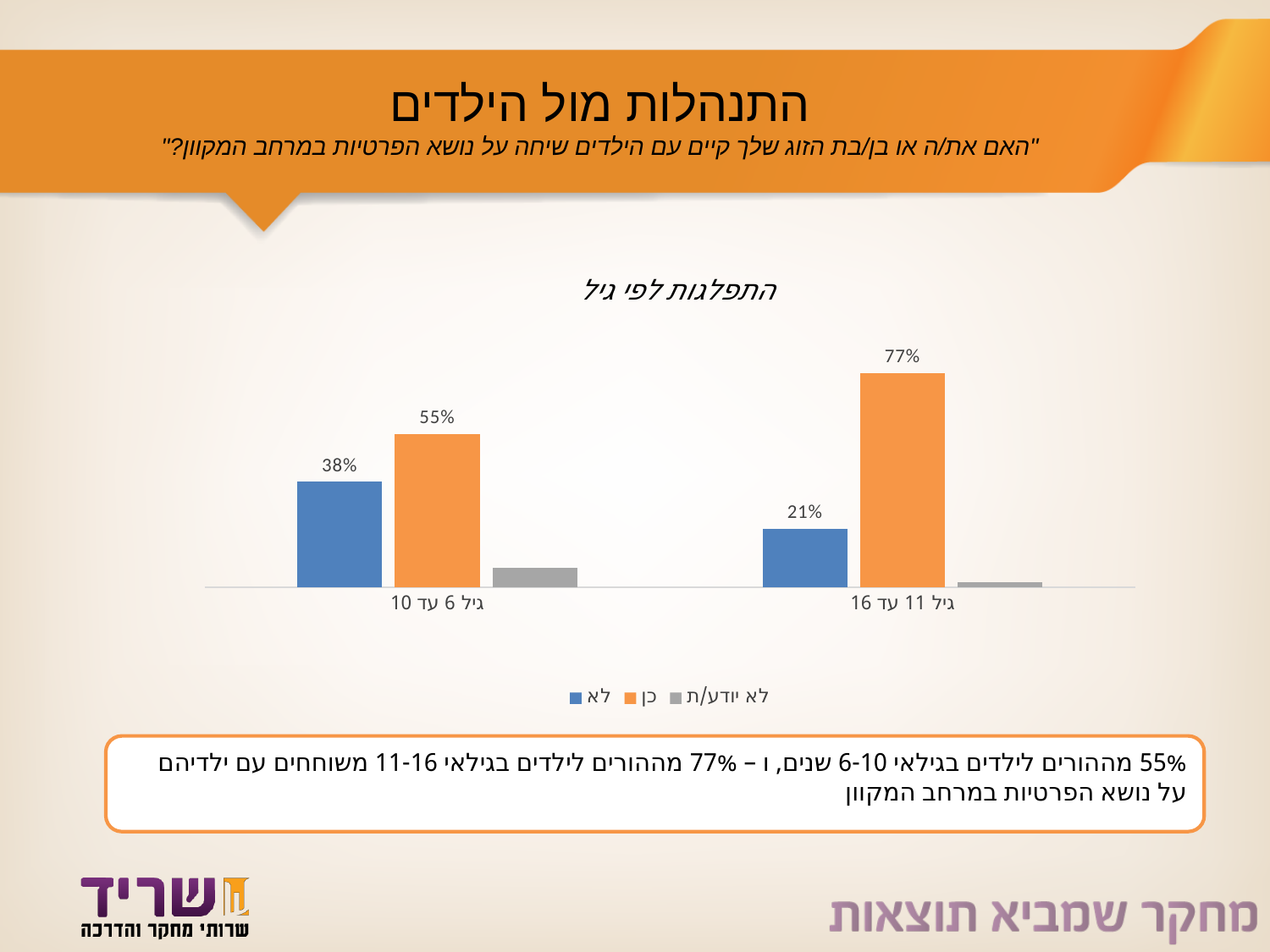
Which category has the highest value for "כן"? גיל 11 עד 16 How many age categories are shown on the x axis? 2 What is the value for "כן" in the "גיל 11 עד 16" category? 77% What is the difference between the "כן" values for "גיל 11 עד 16" and "גיל 6 עד 10"? 22% What is the value for "כן" in the "גיל 6 עד 10" category? 55% Which category has the lowest value for "לא"? גיל 11 עד 16 How many series does the legend list? 3 What is the value for "לא" in the "גיל 11 עד 16" category? 21% What is the difference between the "לא" values for "גיל 6 עד 10" and "גיל 11 עד 16"? 17% What type of chart is shown on the slide? bar chart Which is larger in the "גיל 6 עד 10" category: "כן" or "לא"? כן What is the value for "לא" in the "גיל 6 עד 10" category? 38%